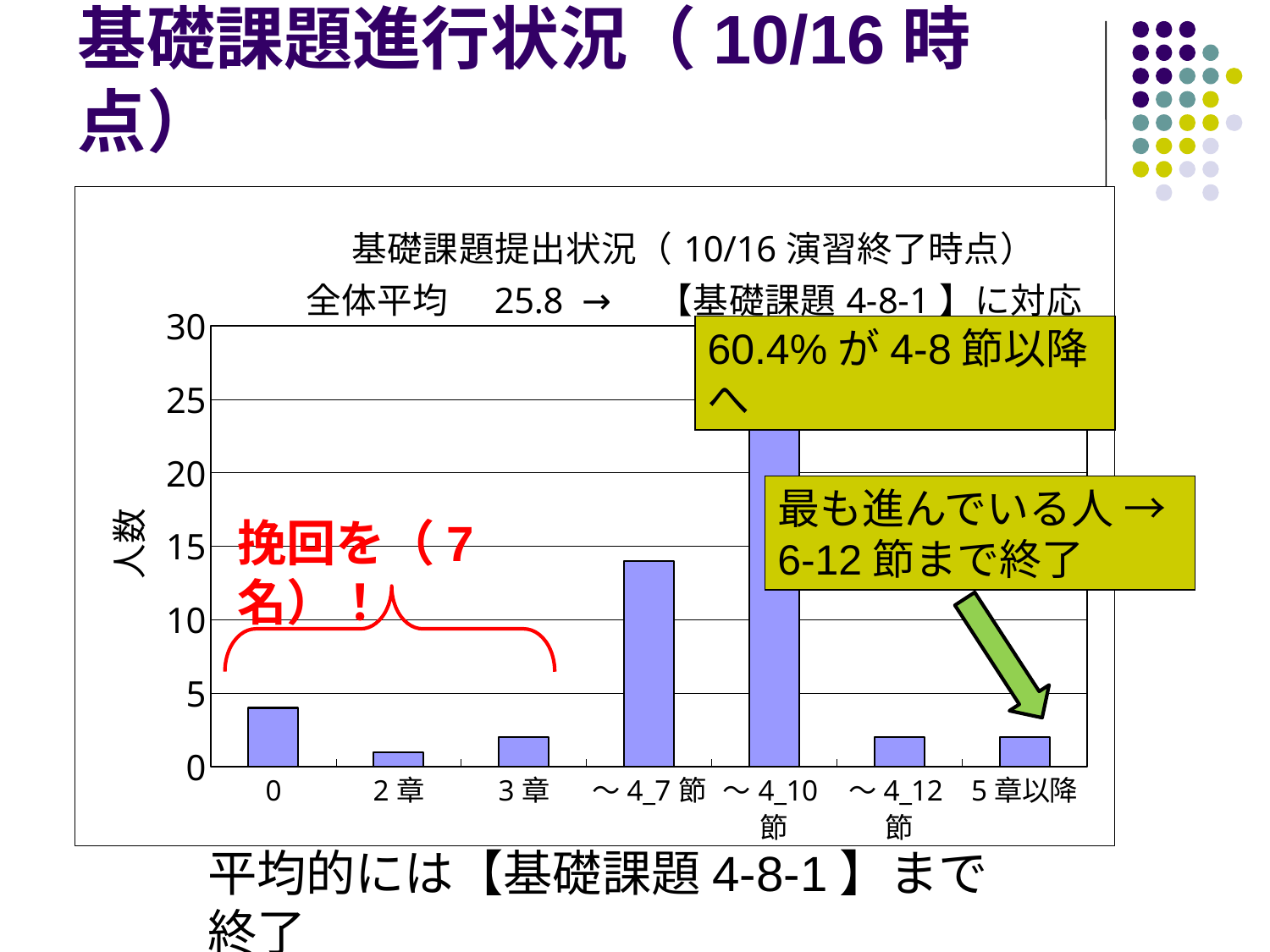
Is the value for 5章以降 greater or less than 5? less Which is larger, the value for 0 or the value for 2章? 0 Is the value for 0 greater or less than 5? less Which category has the highest bar in the chart? ～4_10節 What is the title of the chart? 基礎課題提出状況（10/16演習終了時点） 全体平均 25.8 → 【基礎課題4-8-1】に対応 Is the value for ～4_7節 greater or less than 10? greater Which category has the lowest bar in the chart? 2章 What kind of chart is shown on the slide? bar chart Which is larger, the value for ～4_7節 or the value for ～4_10節? ～4_10節 How many categories are shown on the x axis of the chart? 7 What is the label of the y axis of the chart? 人数